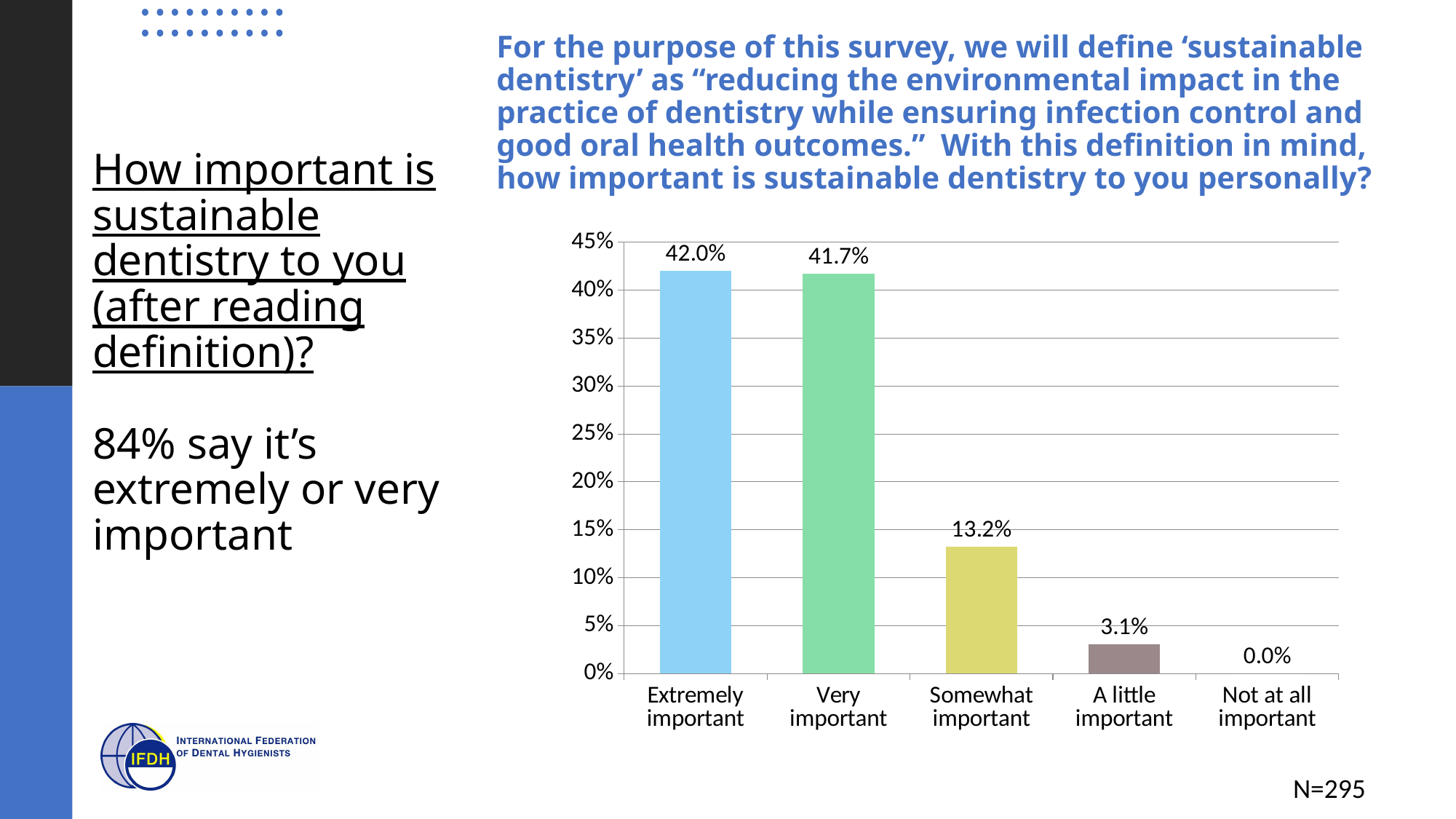
What is the difference in percentage points between 'Somewhat important' and 'A little important'? 10.1 Do the values rise or fall moving from left to right along the x axis? Fall What percentage of respondents said sustainable dentistry is extremely important? 42.0% What percentage of respondents said sustainable dentistry is somewhat important? 13.2% Which category has the lowest percentage? Not at all important What percentage of respondents said sustainable dentistry is not at all important? 0.0% What is the difference in percentage points between 'Very important' and 'Somewhat important'? 28.5 How many categories are shown on the x axis of the chart? 5 What percentage of respondents said sustainable dentistry is a little important? 3.1% Which is larger, the value for 'Very important' or the value for 'Somewhat important'? Very important Which category has the highest percentage? Extremely important What type of chart is shown on the slide? Bar chart